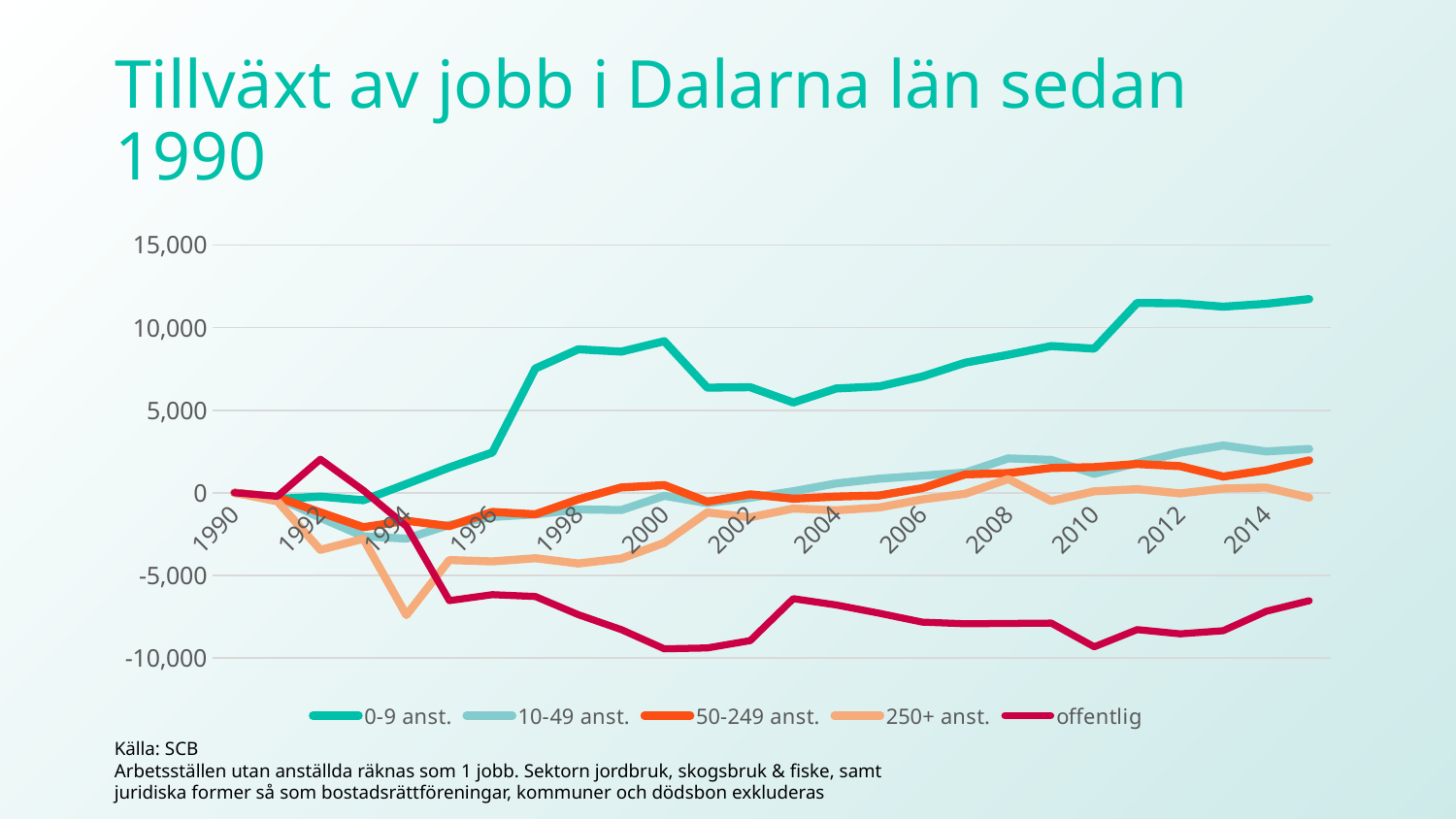
Is the value for 250+ anst. in 1994 greater or less than -5,000? less What are the series names listed in the legend? 0-9 anst., 10-49 anst., 50-249 anst., 250+ anst., offentlig Is the value for offentlig in 2000 greater or less than -5,000? less Is the value for 0-9 anst. in 2014 greater or less than 10,000? greater Which series has the lowest value in 2014? offentlig How many series does the legend list? 5 What kind of chart is shown on the slide? line chart What is the title of the chart on the slide? Tillväxt av jobb i Dalarna län sedan 1990 Which series has the lowest value in 1994? 250+ anst. Which series has the highest value in 2014? 0-9 anst. In 2014, which is larger: the value for 10-49 anst. or the value for 250+ anst.? 10-49 anst.